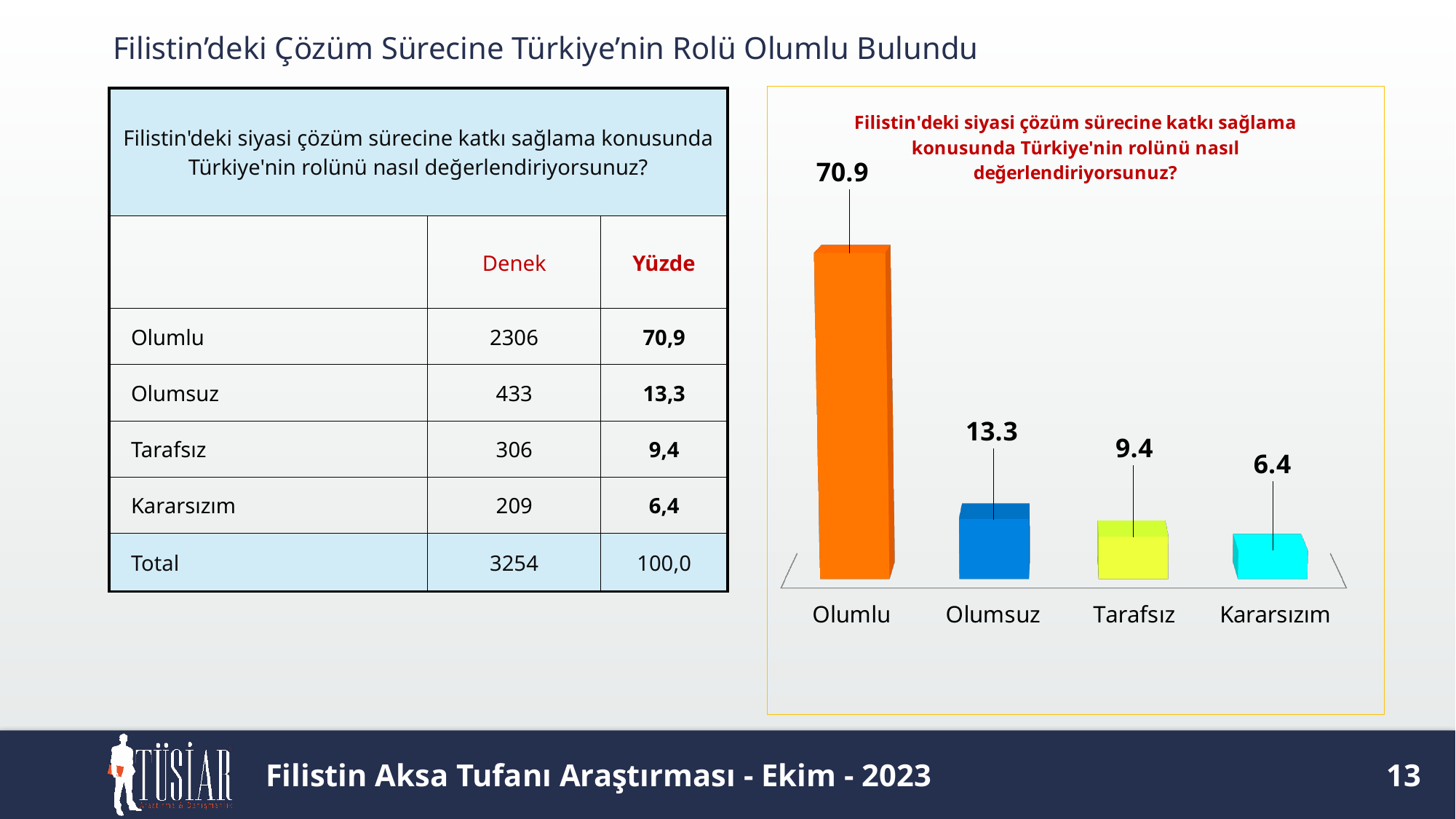
Which category has the lowest value in the chart? Kararsızım How many categories are shown in the chart? 4 Which category has the highest value in the chart? Olumlu What is the value shown for Tarafsız in the chart? 9.4 What is the value shown for Kararsızım in the chart? 6.4 What is the difference between the values for Tarafsız and Kararsızım in the chart? 3.0 What is the value shown for Olumsuz in the chart? 13.3 What kind of chart is shown on the slide? Bar chart Do the values in the chart rise or fall from left to right along the x axis? Fall What is the difference between the values for Olumlu and Olumsuz in the chart? 57.6 What is the value shown for Olumlu in the chart? 70.9 Which is larger in the chart, the value for Olumsuz or the value for Tarafsız? Olumsuz